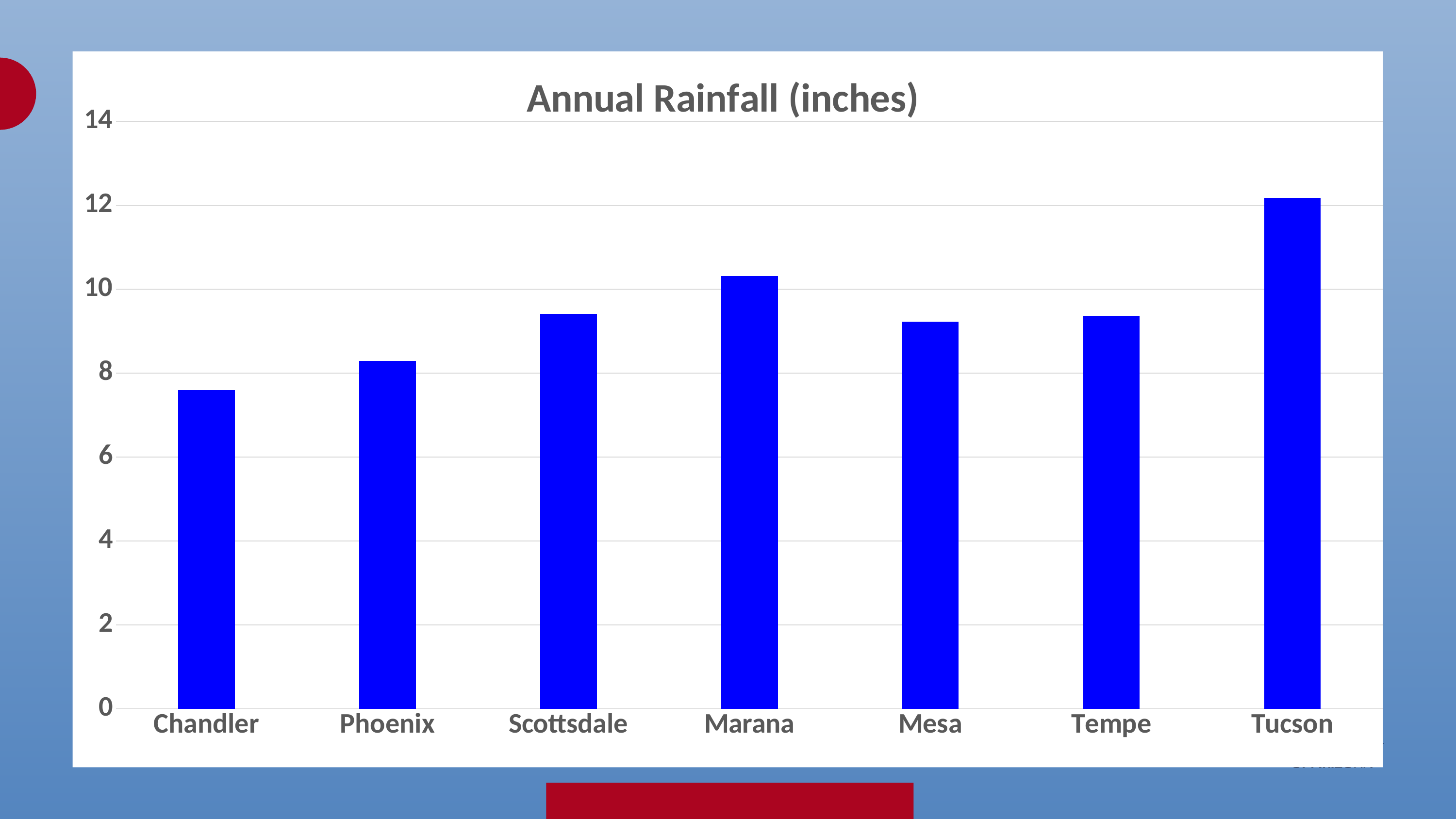
Is the value for Mesa greater or less than 10? less Which city has the lowest annual rainfall in the chart? Chandler What colour are the bars in the chart? blue Is the value for Chandler greater or less than 8? less Is the value for Marana greater or less than 10? greater Which city has the highest annual rainfall in the chart? Tucson What kind of chart is shown on the slide? bar chart Which has the larger annual rainfall, Marana or Phoenix? Marana How many cities are shown on the x axis of the chart? 7 What is the title of the chart? Annual Rainfall (inches)